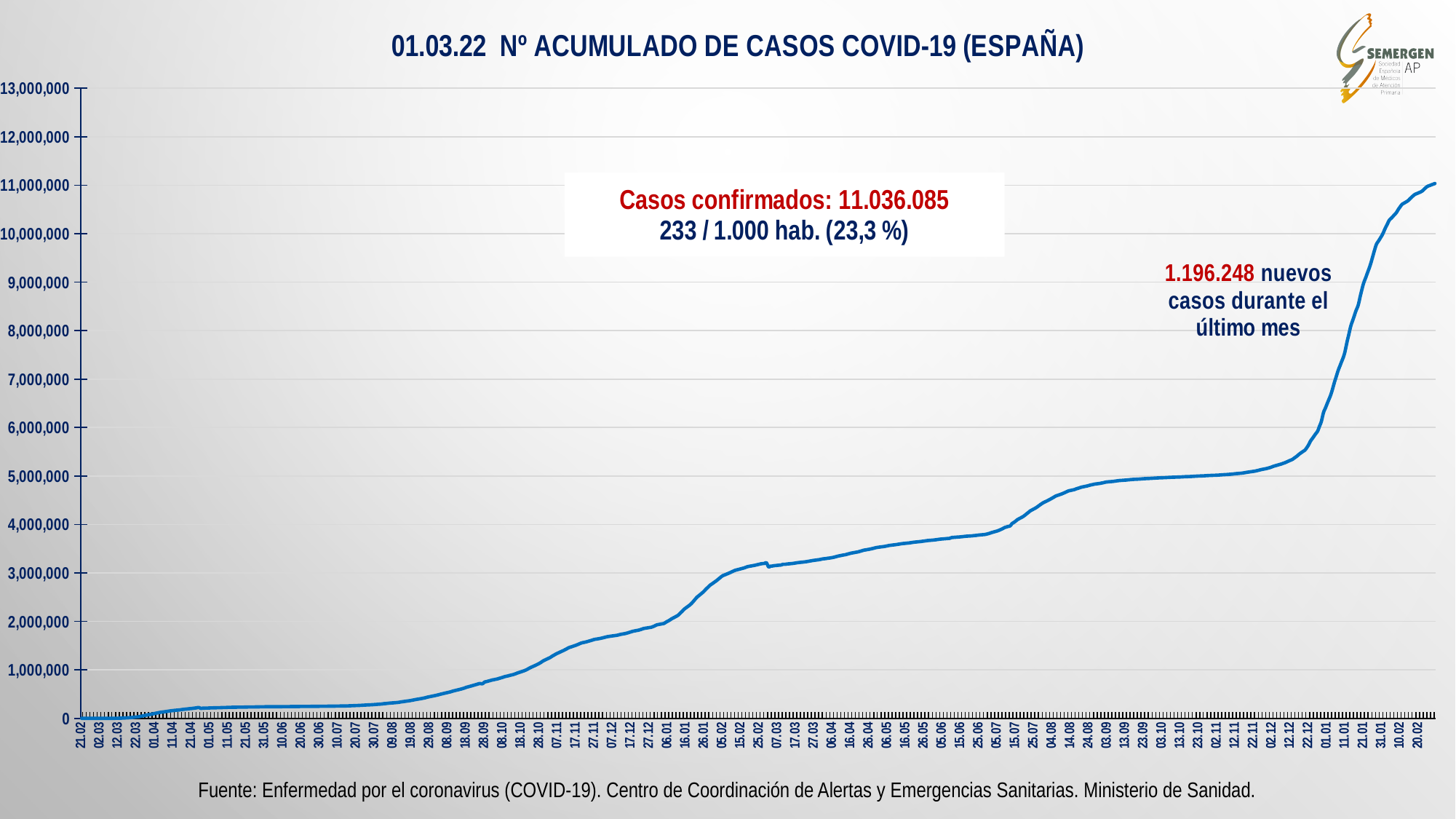
Is the value at 28.09 greater or less than 1,000,000? less Is the value at 11.01 greater or less than 7,000,000? greater Do the values rise or fall along the x axis from 21.02 to 20.02? rise What is the title of the chart? 01.03.22 Nº ACUMULADO DE CASOS COVID-19 (ESPAÑA) Which is larger, the value at 24.08 or the value at 12.12? 12.12 How many new cases during the last month does the slide report? 1.196.248 Is the value at 25.06 greater or less than 4,000,000? less What rate per 1.000 inhabitants is stated on the slide? 233 / 1.000 hab. (23,3 %) What kind of chart is shown on the slide? line chart What is the number of confirmed cases stated on the slide? 11.036.085